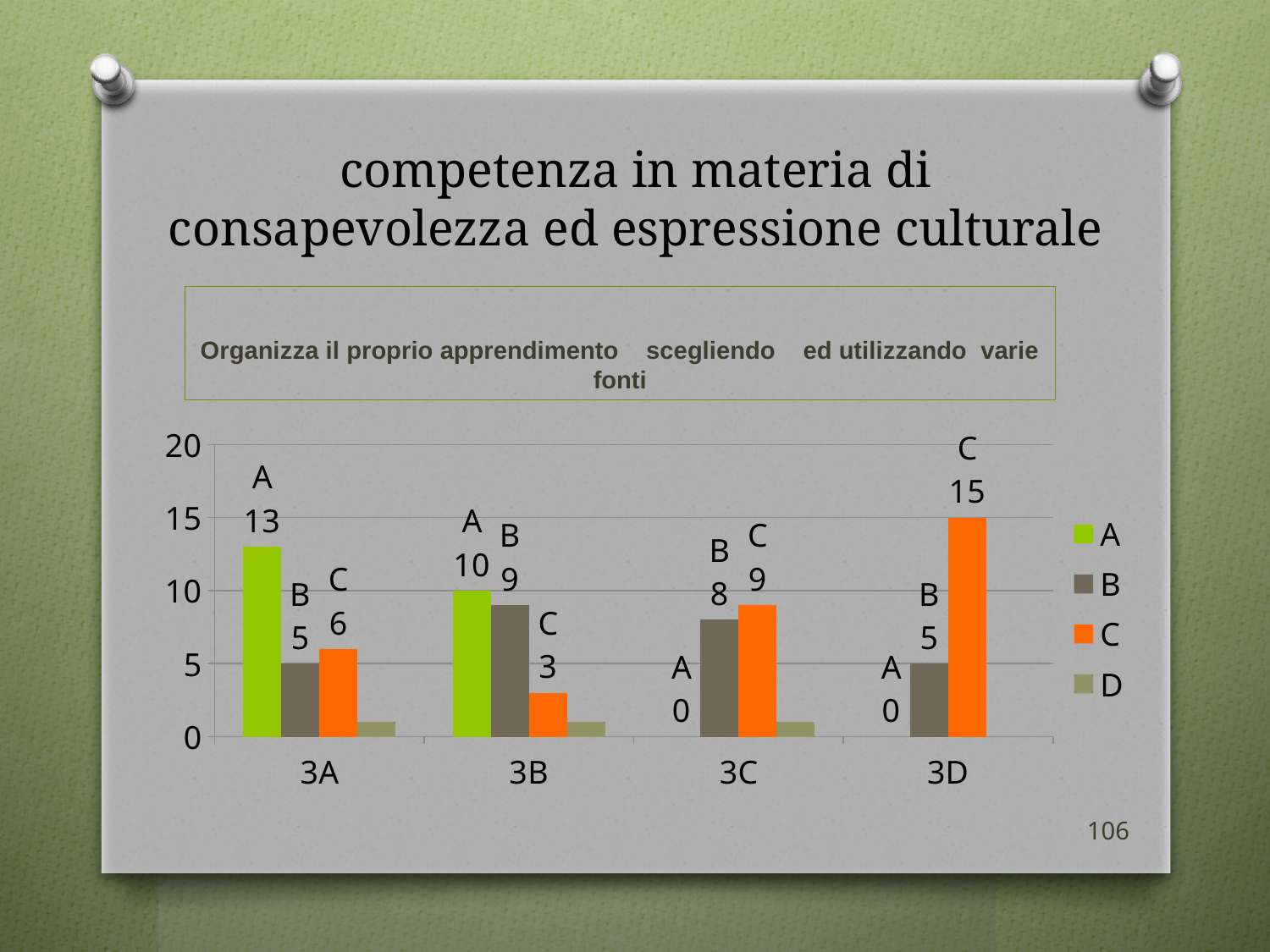
Which class has the lowest value for series C? 3B How many classes are shown on the x axis? 4 What is the value of series C for class 3D? 15 What is the value of series B for class 3C? 8 What is the difference between series A and series B for class 3A? 8 Do the values of series A rise or fall from class 3A to class 3D? fall What kind of chart is shown on the slide? bar chart What is the value of series A for class 3A? 13 For class 3B, which is larger: series B or series C? B How many series does the legend list? 4 Which class has the highest value for series C? 3D What is the value of series A for class 3C? 0